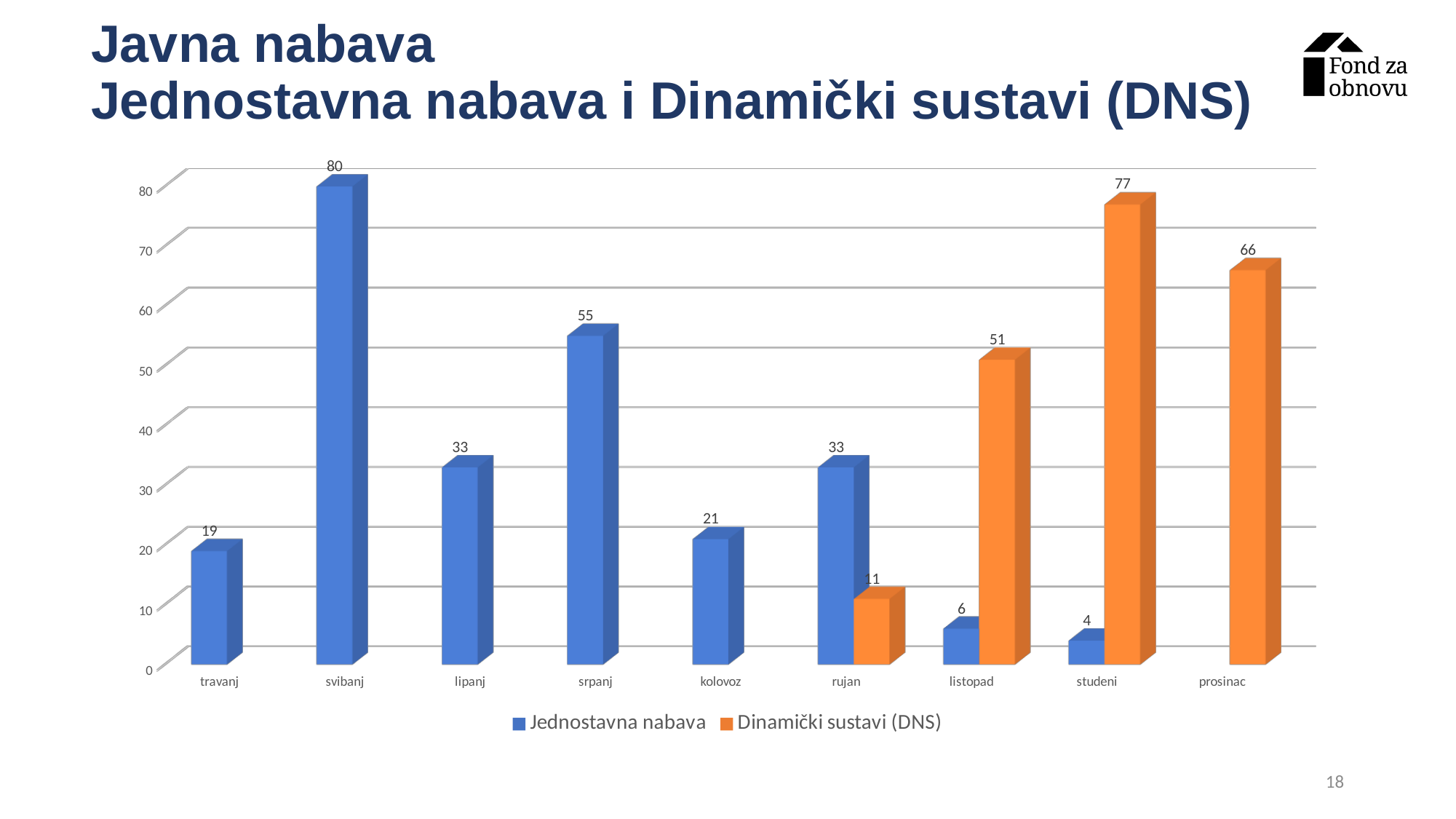
What is the value of Dinamički sustavi (DNS) for rujan? 11 What kind of chart is shown on the slide? bar chart Which month has the highest value for Jednostavna nabava? svibanj How many months are shown on the x axis? 9 What is the value of Dinamički sustavi (DNS) for studeni? 77 What is the difference between the Jednostavna nabava values for svibanj and srpanj? 25 Which month has the highest value for Dinamički sustavi (DNS)? studeni What is the value of Jednostavna nabava for kolovoz? 21 How many series does the legend list? 2 What is the value of Jednostavna nabava for svibanj? 80 Which is larger: Dinamički sustavi (DNS) for listopad or Jednostavna nabava for srpanj? Jednostavna nabava for srpanj Which month has the lowest value for Jednostavna nabava? studeni